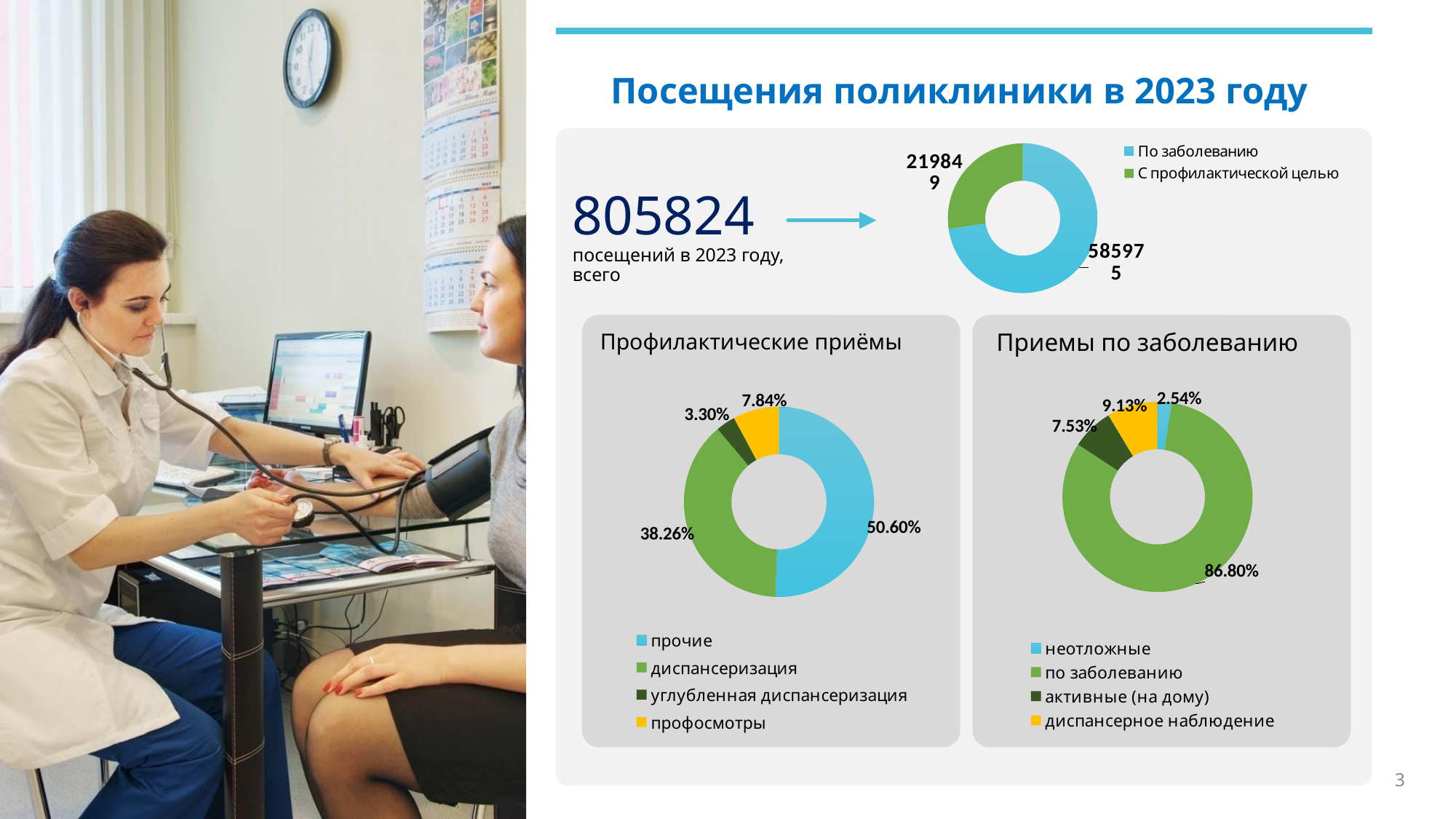
How many categories does the legend of the 'Приемы по заболеванию' chart list? 4 In the 'Профилактические приёмы' chart, what is the difference between the shares of 'прочие' and 'диспансеризация'? 12.34% In the 'Приемы по заболеванию' chart, what share is 'диспансерное наблюдение'? 9.13% What kind of chart is used for 'Профилактические приёмы'? Donut (pie) chart In the 'Приемы по заболеванию' chart, what share is 'по заболеванию'? 86.80% In the 'Профилактические приёмы' chart, which category has the smallest share? углубленная диспансеризация In the 'Приемы по заболеванию' chart, which category has the smallest share? неотложные In the top donut chart, which category is larger: 'По заболеванию' or 'С профилактической целью'? По заболеванию In the 'Профилактические приёмы' chart, what share is 'диспансеризация'? 38.26% In the 'Приемы по заболеванию' chart, which is larger: 'активные (на дому)' or 'диспансерное наблюдение'? диспансерное наблюдение What total number of visits in 2023 is shown on the slide? 805824 In the 'Профилактические приёмы' chart, what share is 'прочие'? 50.60%